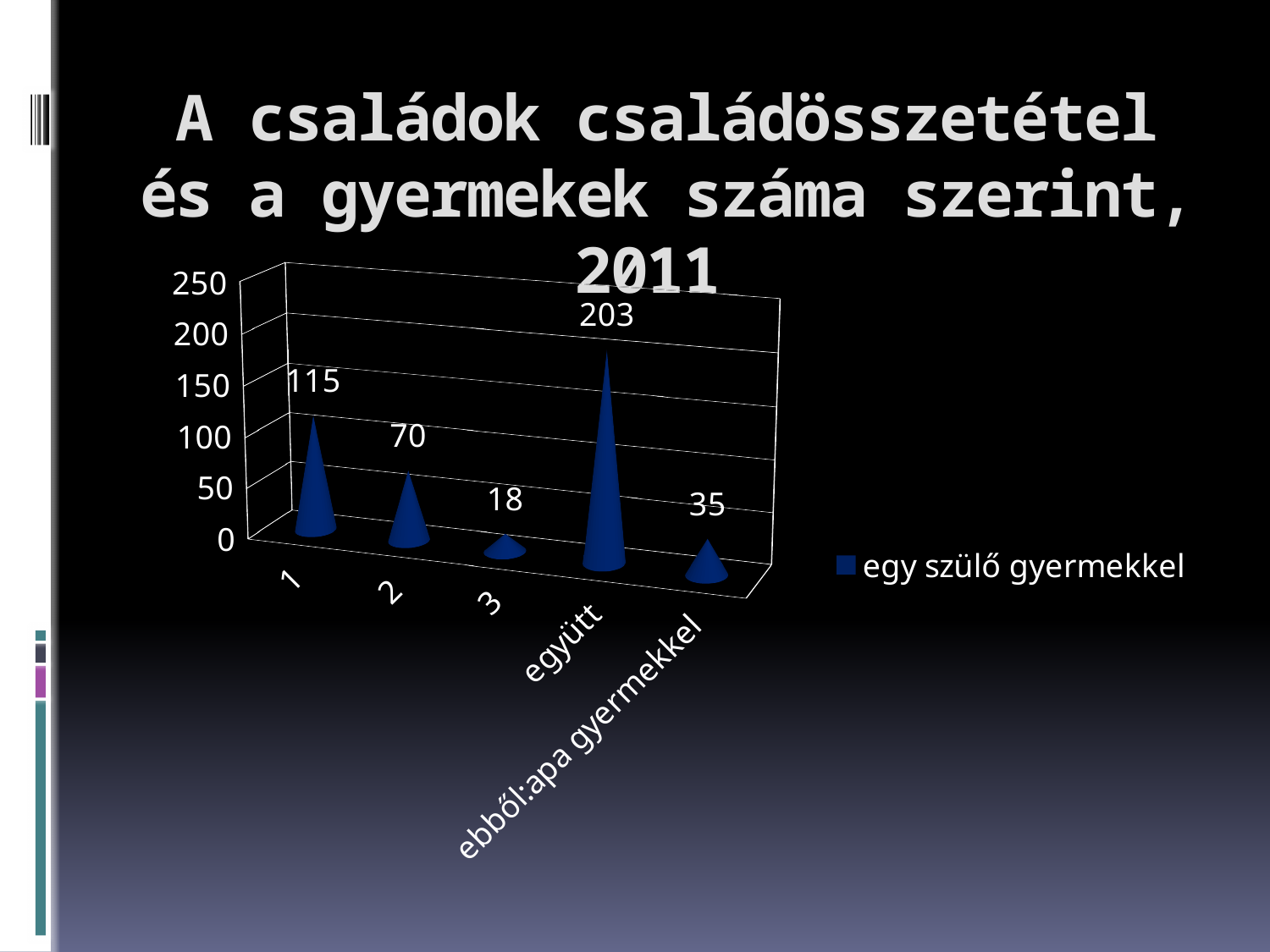
What is the value for category "3" in the chart? 18 What is the value for category "1" in the chart? 115 What is the difference between the values for "együtt" and "ebből:apa gyermekkel"? 168 How many series does the chart legend list? 1 Which category has the lowest value in the chart? 3 How many categories are shown on the x axis of the chart? 5 What is the value for category "2" in the chart? 70 What is the value for "együtt" in the chart? 203 Which category has the highest value in the chart? együtt What series name is shown in the chart legend? egy szülő gyermekkel What is the value for "ebből:apa gyermekkel" in the chart? 35 Which is larger, the value for category "1" or the value for category "2"? 1